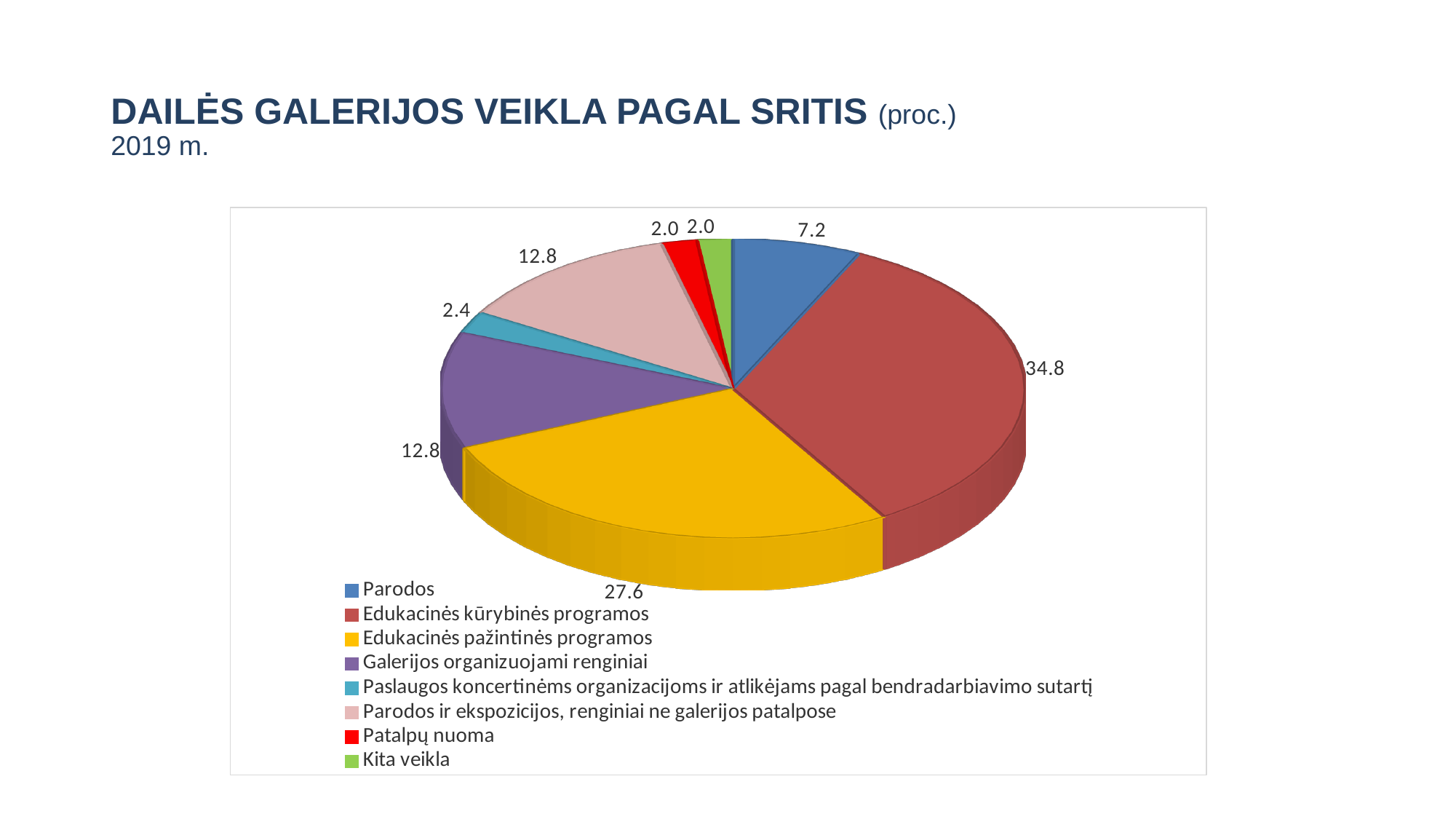
What is the difference between the values for Galerijos organizuojami renginiai and Parodos? 5.6 Which colour represents Kita veikla in the legend? green What is the value for Patalpų nuoma? 2.0 How many categories does the pie chart have? 8 What is the value for Edukacinės kūrybinės programos? 34.8 What is the value for Parodos? 7.2 What is the value for Paslaugos koncertinėms organizacijoms ir atlikėjams pagal bendradarbiavimo sutartį? 2.4 Which category has the largest slice of the pie? Edukacinės kūrybinės programos What type of chart is shown on the slide? pie chart What is the difference between the values for Edukacinės kūrybinės programos and Edukacinės pažintinės programos? 7.2 Which is larger, the value for Parodos or the value for Galerijos organizuojami renginiai? Galerijos organizuojami renginiai What is the value for Edukacinės pažintinės programos? 27.6